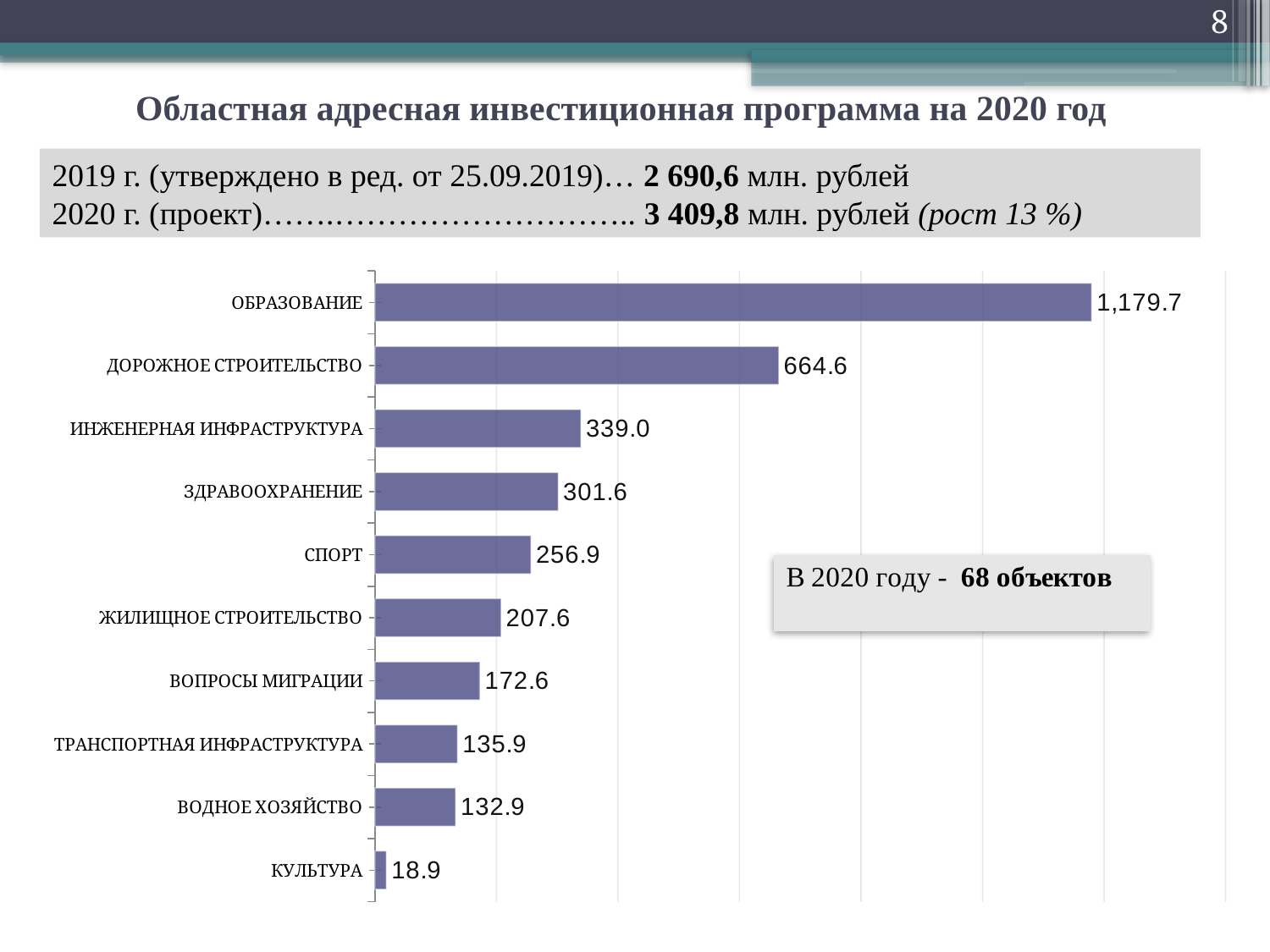
What is the value for ОБРАЗОВАНИЕ? 1,179.7 What is the title of the slide containing the chart? Областная адресная инвестиционная программа на 2020 год Which category has the highest value? ОБРАЗОВАНИЕ What is the difference between the values for ОБРАЗОВАНИЕ and ДОРОЖНОЕ СТРОИТЕЛЬСТВО? 515.1 What is the value for ЗДРАВООХРАНЕНИЕ? 301.6 How many categories are shown in the chart? 10 What kind of chart is shown on the slide? bar chart What is the difference between the values for ИНЖЕНЕРНАЯ ИНФРАСТРУКТУРА and ЗДРАВООХРАНЕНИЕ? 37.4 What is the value for ВОДНОЕ ХОЗЯЙСТВО? 132.9 Which is larger, the value for СПОРТ or the value for ЖИЛИЩНОЕ СТРОИТЕЛЬСТВО? СПОРТ What is the value for ВОПРОСЫ МИГРАЦИИ? 172.6 Which category has the lowest value? КУЛЬТУРА